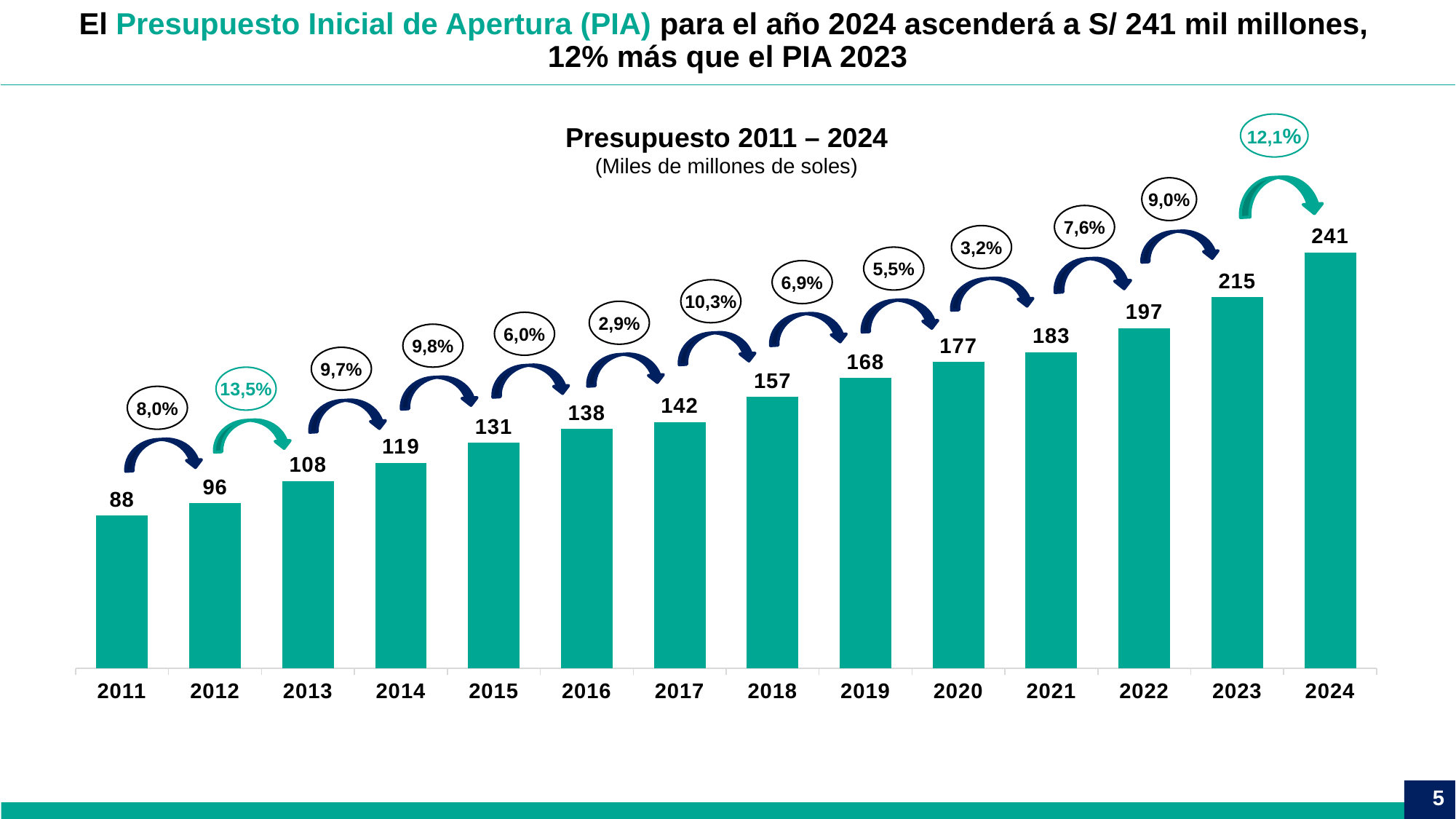
Which year has the highest value? 2024 What is the difference between the values for 2024 and 2023? 26 What percentage growth is shown between 2012 and 2013? 13,5% What kind of chart is this? bar chart What is the difference between the values for 2016 and 2015? 7 What is the value for 2024? 241 What is the value for 2011? 88 Which is larger, the value for 2019 or the value for 2017? 2019 Which year has the lowest value? 2011 How many years are shown on the x axis? 14 Do the values rise or fall from 2011 to 2024? rise What is the value for 2018? 157